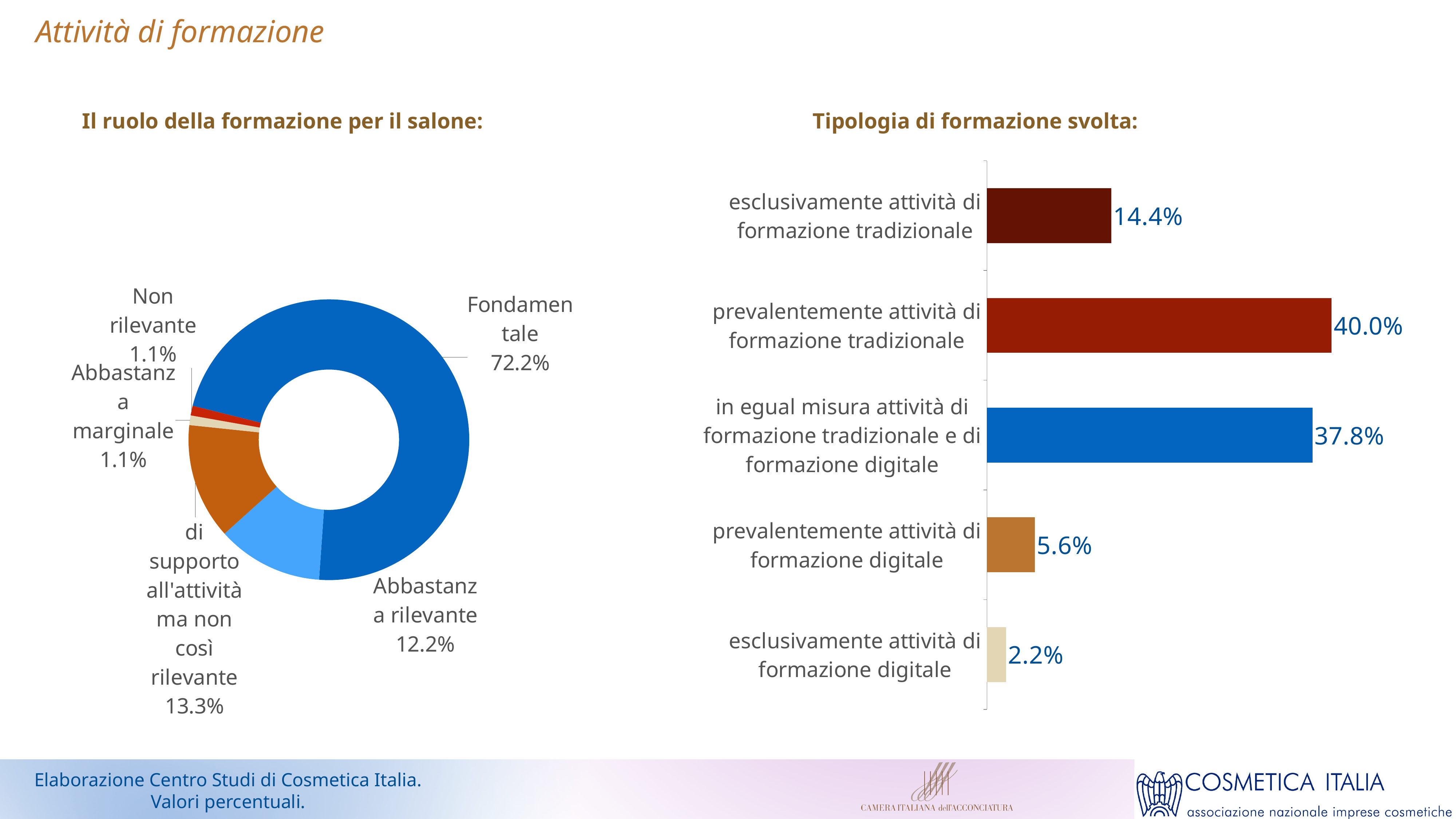
In the chart 'Il ruolo della formazione per il salone:', which category has the largest share? Fondamentale In the chart 'Tipologia di formazione svolta:', what is the value for 'esclusivamente attività di formazione digitale'? 2.2% In the chart 'Tipologia di formazione svolta:', what is the difference between 'prevalentemente attività di formazione tradizionale' and 'in egual misura attività di formazione tradizionale e di formazione digitale'? 2.2% In the chart 'Tipologia di formazione svolta:', how many categories are shown? 5 In the chart 'Tipologia di formazione svolta:', which category has the lowest value? esclusivamente attività di formazione digitale In the chart 'Il ruolo della formazione per il salone:', what kind of chart is shown? Doughnut chart In the chart 'Il ruolo della formazione per il salone:', what share is labelled for 'Fondamentale'? 72.2% In the chart 'Il ruolo della formazione per il salone:', what share is labelled for 'di supporto all'attività ma non così rilevante'? 13.3% In the chart 'Il ruolo della formazione per il salone:', which is larger: 'Abbastanza rilevante' or 'di supporto all'attività ma non così rilevante'? di supporto all'attività ma non così rilevante In the chart 'Tipologia di formazione svolta:', what is the value for 'prevalentemente attività di formazione tradizionale'? 40.0% In the chart 'Il ruolo della formazione per il salone:', how many categories are shown? 5 In the chart 'Tipologia di formazione svolta:', what kind of chart is shown? Bar chart